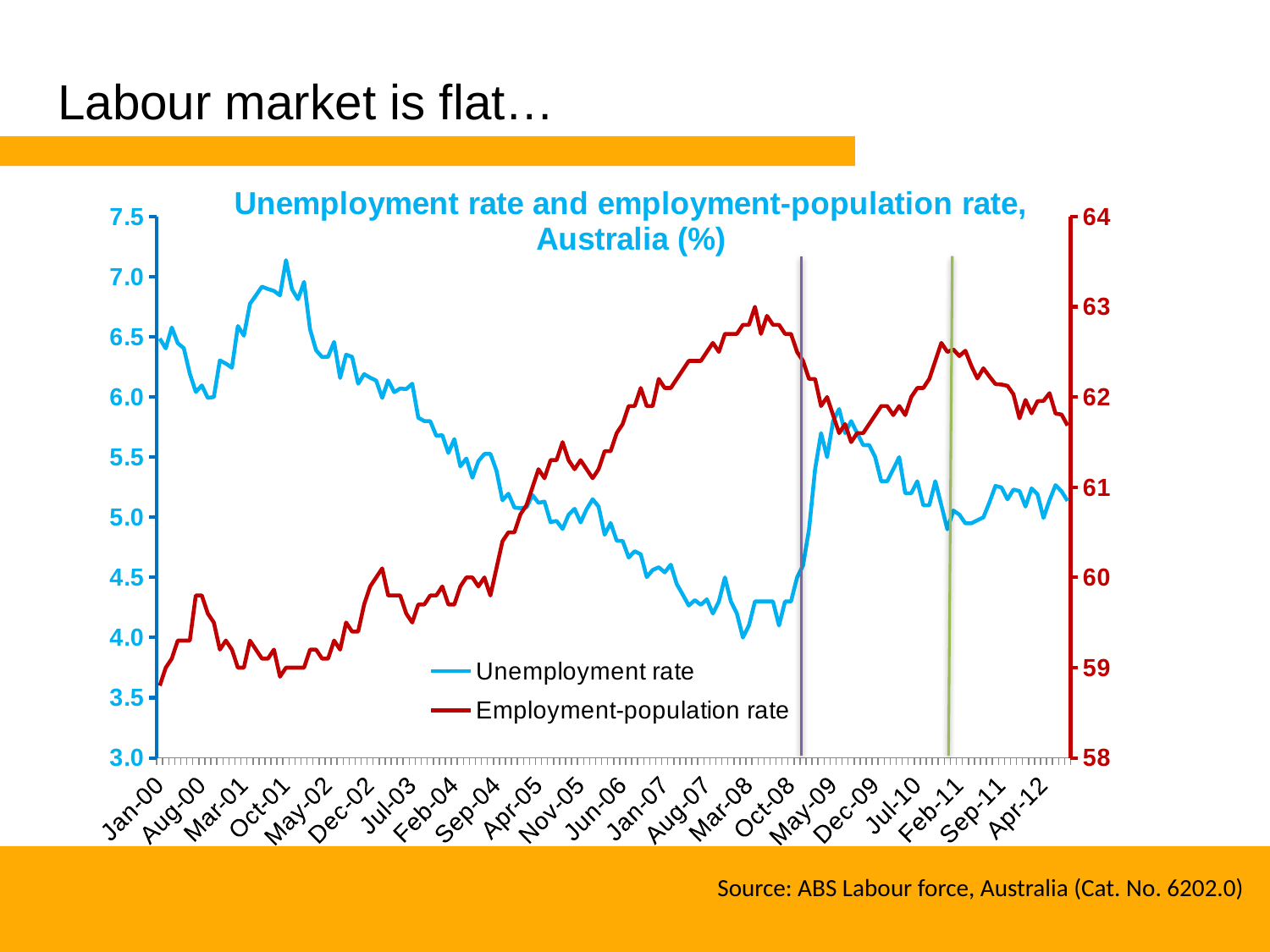
Is the Employment-population rate at Jan-00 greater or less than 59? less Does the Employment-population rate rise or fall between Jan-00 and Mar-08? Rise What colour is the line for the Unemployment rate? Blue How many series does the legend list? 2 What is the title of the chart? Unemployment rate and employment-population rate, Australia (%) Is the Unemployment rate around Oct-01 greater or less than 6.5? greater Is the Employment-population rate around Mar-08 greater or less than 62? greater Is the Unemployment rate higher around Oct-01 or around Mar-08? Oct-01 Does the Unemployment rate rise or fall between Oct-01 and Mar-08? Fall What kind of chart is shown on the slide? Line chart